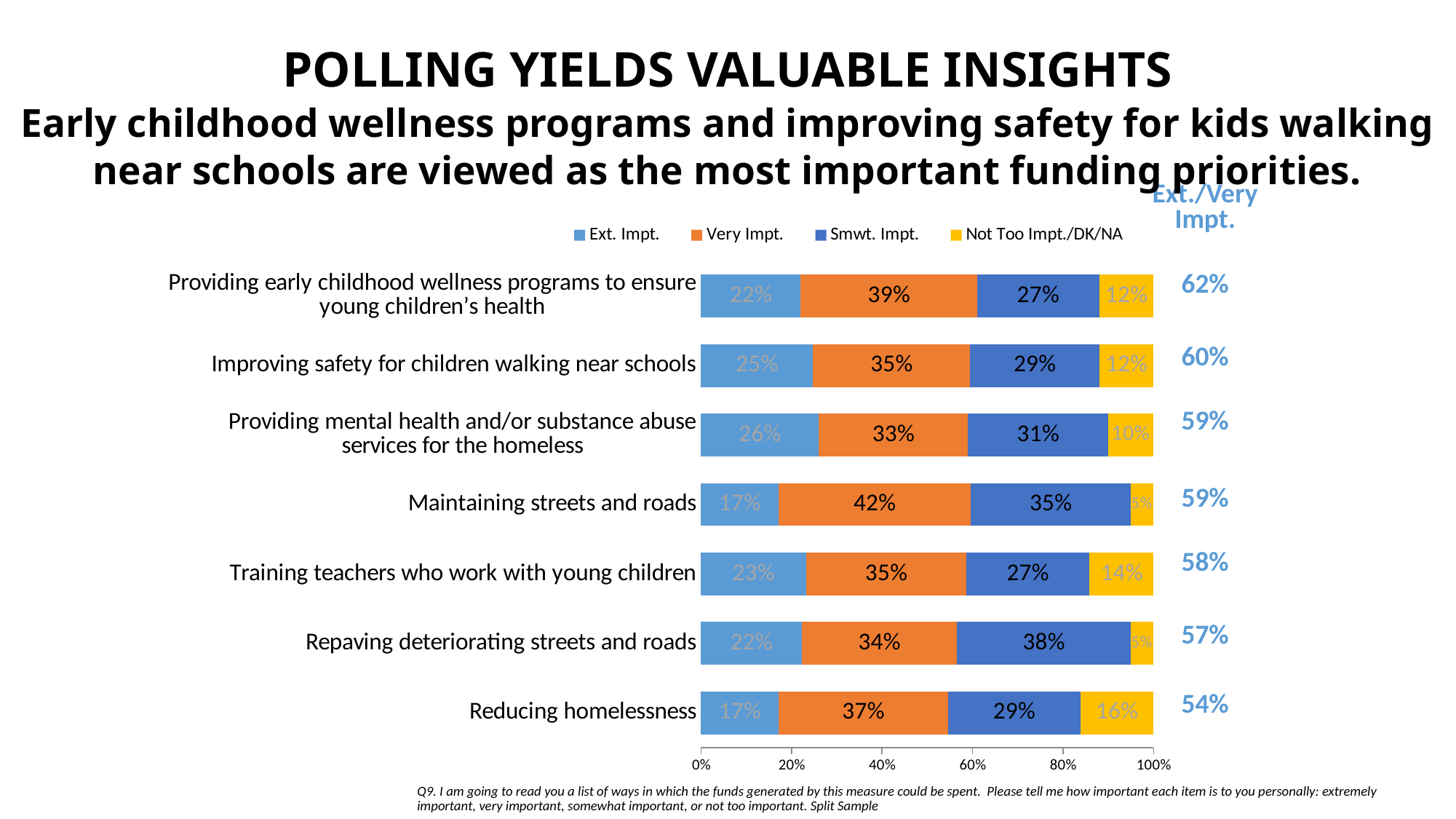
What kind of chart is shown on the slide? Stacked bar chart What is the Smwt. Impt. value for 'Repaving deteriorating streets and roads'? 38% Which colour represents the 'Not Too Impt./DK/NA' series? Yellow Which category has the highest Ext./Very Impt. combined percentage? Providing early childhood wellness programs to ensure young children's health How many series does the legend list? 4 How many categories are shown in the chart? 7 What is the Ext. Impt. value for 'Providing mental health and/or substance abuse services for the homeless'? 26% Which has a larger Smwt. Impt. value: 'Repaving deteriorating streets and roads' or 'Training teachers who work with young children'? Repaving deteriorating streets and roads What is the difference between the Very Impt. values for 'Maintaining streets and roads' and 'Providing mental health and/or substance abuse services for the homeless'? 9% What is the Not Too Impt./DK/NA value for 'Reducing homelessness'? 16% What percentage of respondents rated 'Maintaining streets and roads' as Very Impt.? 42% Which category has the lowest Ext./Very Impt. combined percentage? Reducing homelessness